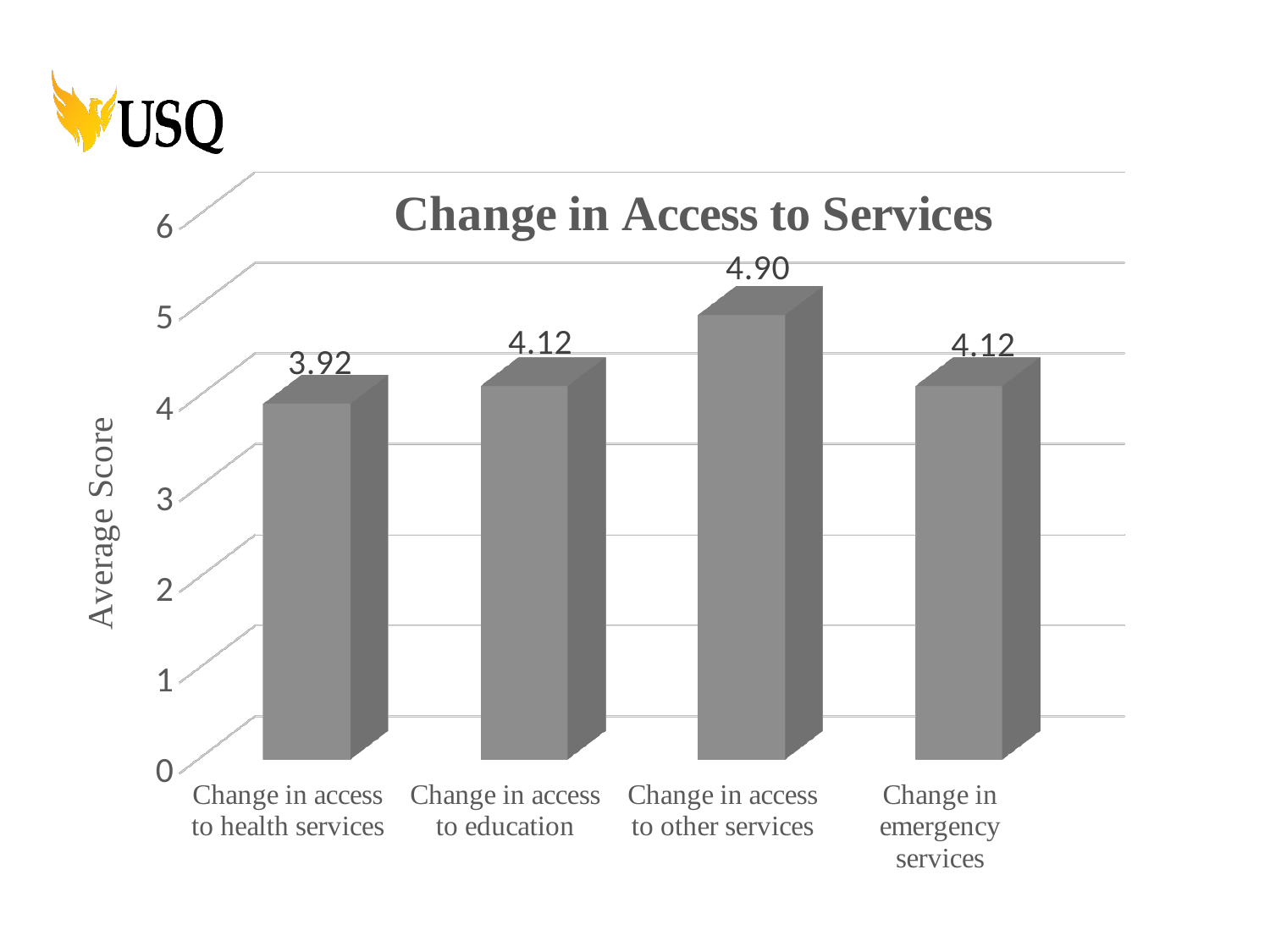
How many categories are shown in the chart? 4 What is the title of the chart? Change in Access to Services Which category has the lowest average score? Change in access to health services What kind of chart is shown on the slide? Bar chart What is the average score for Change in emergency services? 4.12 Which category has the highest average score? Change in access to other services What is the average score for Change in access to education? 4.12 What is the difference between the average score for Change in access to education and Change in access to health services? 0.20 Which is larger, the average score for Change in access to other services or Change in access to education? Change in access to other services What is the average score for Change in access to other services? 4.90 What is the average score for Change in access to health services? 3.92 What is the difference between the average score for Change in access to other services and Change in access to health services? 0.98